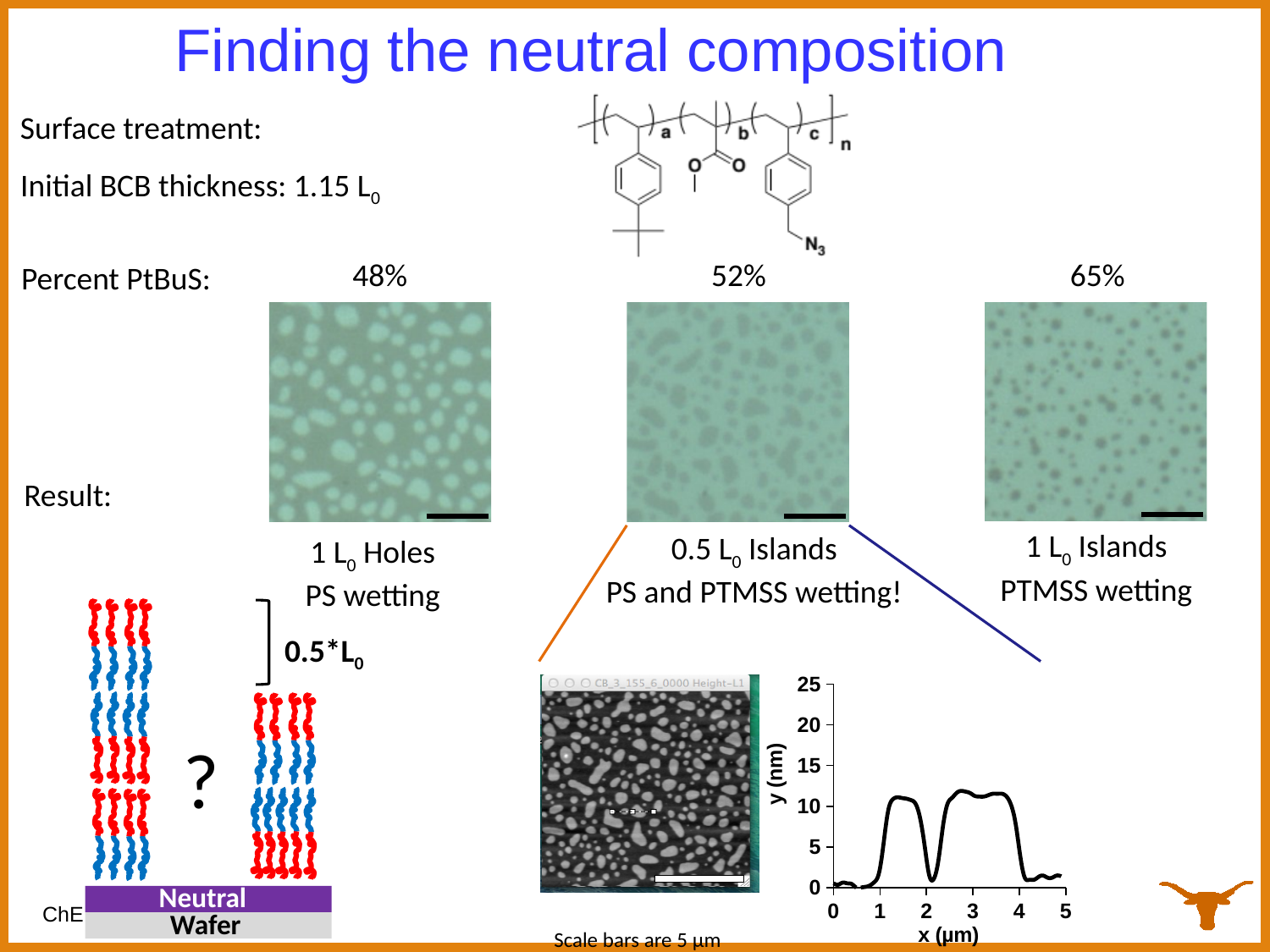
In the line chart, is the value at x = 3 greater or less than 10? greater What is the label of the y axis of the line chart? y (nm) In the line chart, is the value at x = 0.5 greater or less than 5? less What kind of chart is shown at the bottom right of the slide? line chart What is the maximum value shown on the y axis of the line chart? 25 In the line chart, is the value at x = 4.5 greater or less than 5? less What is the label of the x axis of the line chart? x (μm) In the line chart, is the value at x = 1.5 larger or smaller than the value at x = 2? larger